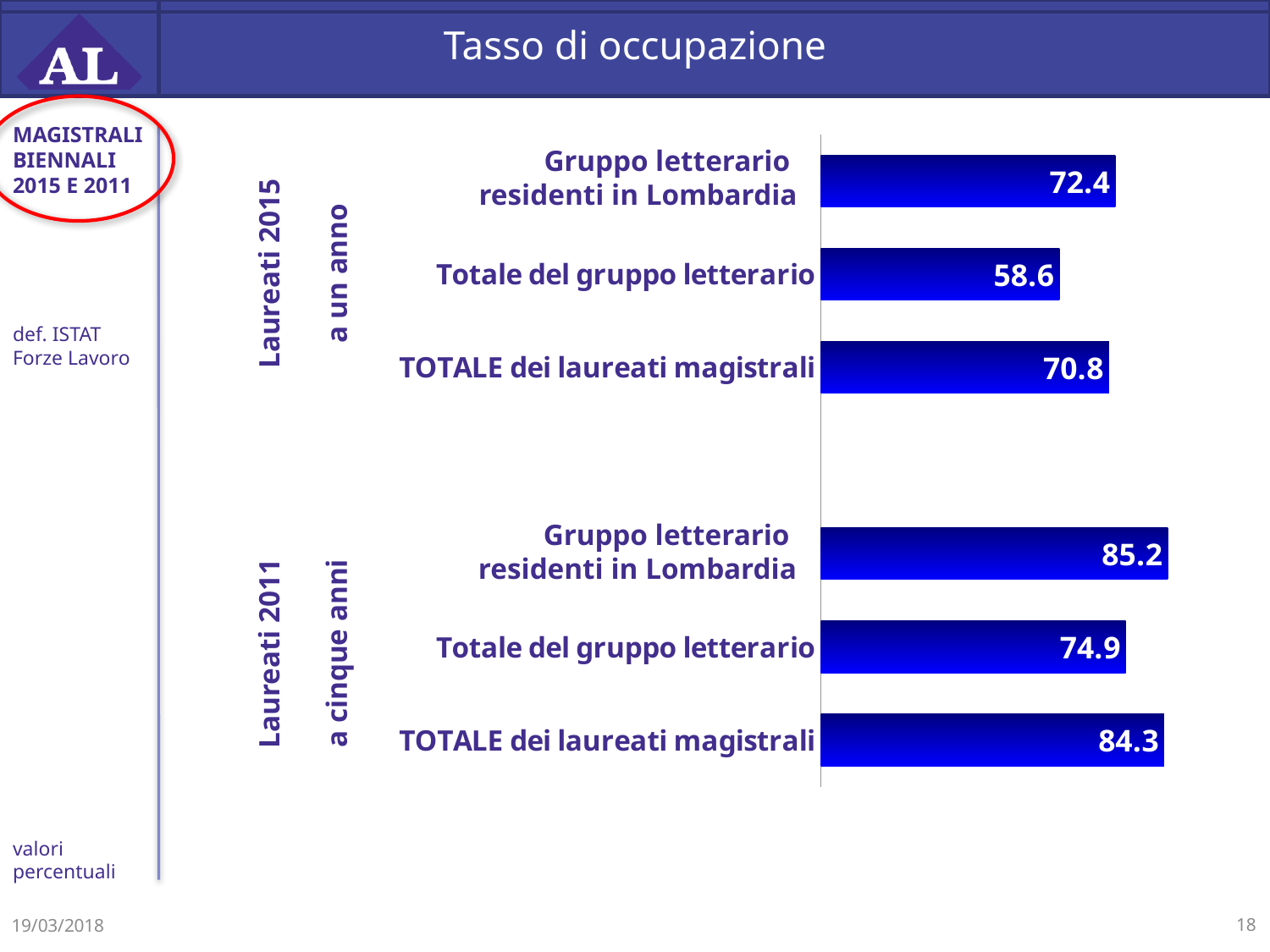
What is the value for 'Totale del gruppo letterario' among Laureati 2011 (a cinque anni)? 74.9 Which is larger: 'Totale del gruppo letterario' for Laureati 2015 or 'TOTALE dei laureati magistrali' for Laureati 2015? TOTALE dei laureati magistrali What is the title of the slide containing the chart? Tasso di occupazione What is the difference between 'Gruppo letterario residenti in Lombardia' for Laureati 2011 and for Laureati 2015? 12.8 What is the value for 'TOTALE dei laureati magistrali' among Laureati 2015 (a un anno)? 70.8 What is the employment rate for 'Gruppo letterario residenti in Lombardia' among Laureati 2015 (a un anno)? 72.4 What is the difference between 'Gruppo letterario residenti in Lombardia' and 'Totale del gruppo letterario' among Laureati 2015? 13.8 How many bars are plotted on the chart in total? 6 Which bar has the highest value on the chart? Gruppo letterario residenti in Lombardia (Laureati 2011) What is the value for 'TOTALE dei laureati magistrali' among Laureati 2011 (a cinque anni)? 84.3 What type of chart is shown on the slide? Bar chart Which bar has the lowest value on the chart? Totale del gruppo letterario (Laureati 2015)